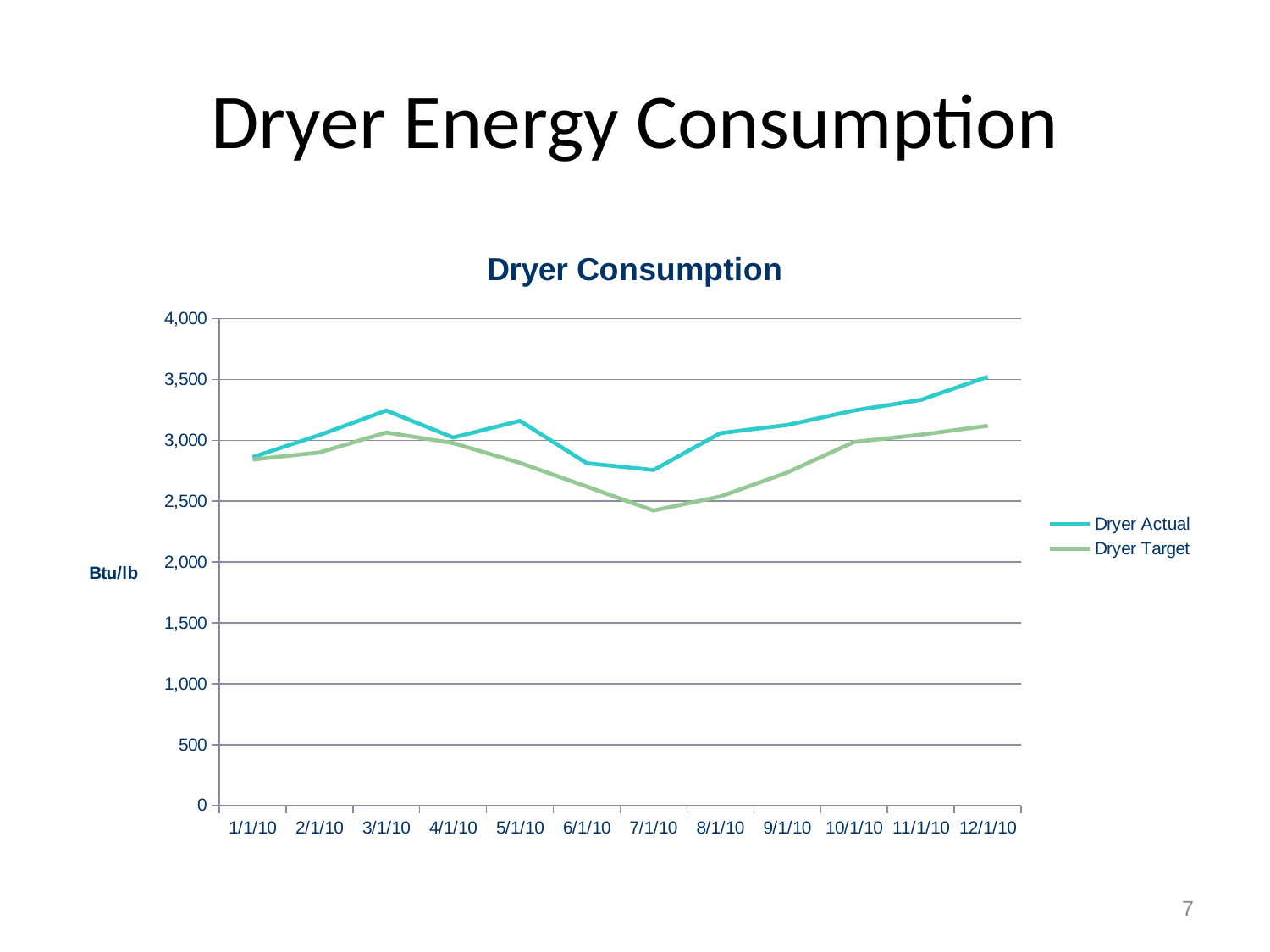
Is the value for Dryer Actual on 3/1/10 greater or less than 3,000? greater On 7/1/10, which is larger, Dryer Actual or Dryer Target? Dryer Actual Is the value for Dryer Actual on 7/1/10 greater or less than 2,500? greater How many series does the legend list? 2 What kind of chart is shown on the slide? line chart Which date has the highest value for Dryer Actual? 12/1/10 Is the value for Dryer Target on 7/1/10 greater or less than 2,500? less Does the Dryer Actual line rise or fall from 7/1/10 to 12/1/10? rise How many dates are plotted along the x axis? 12 Which date has the lowest value for Dryer Target? 7/1/10 What is the label on the vertical axis? Btu/lb Which date has the highest value for Dryer Target? 12/1/10